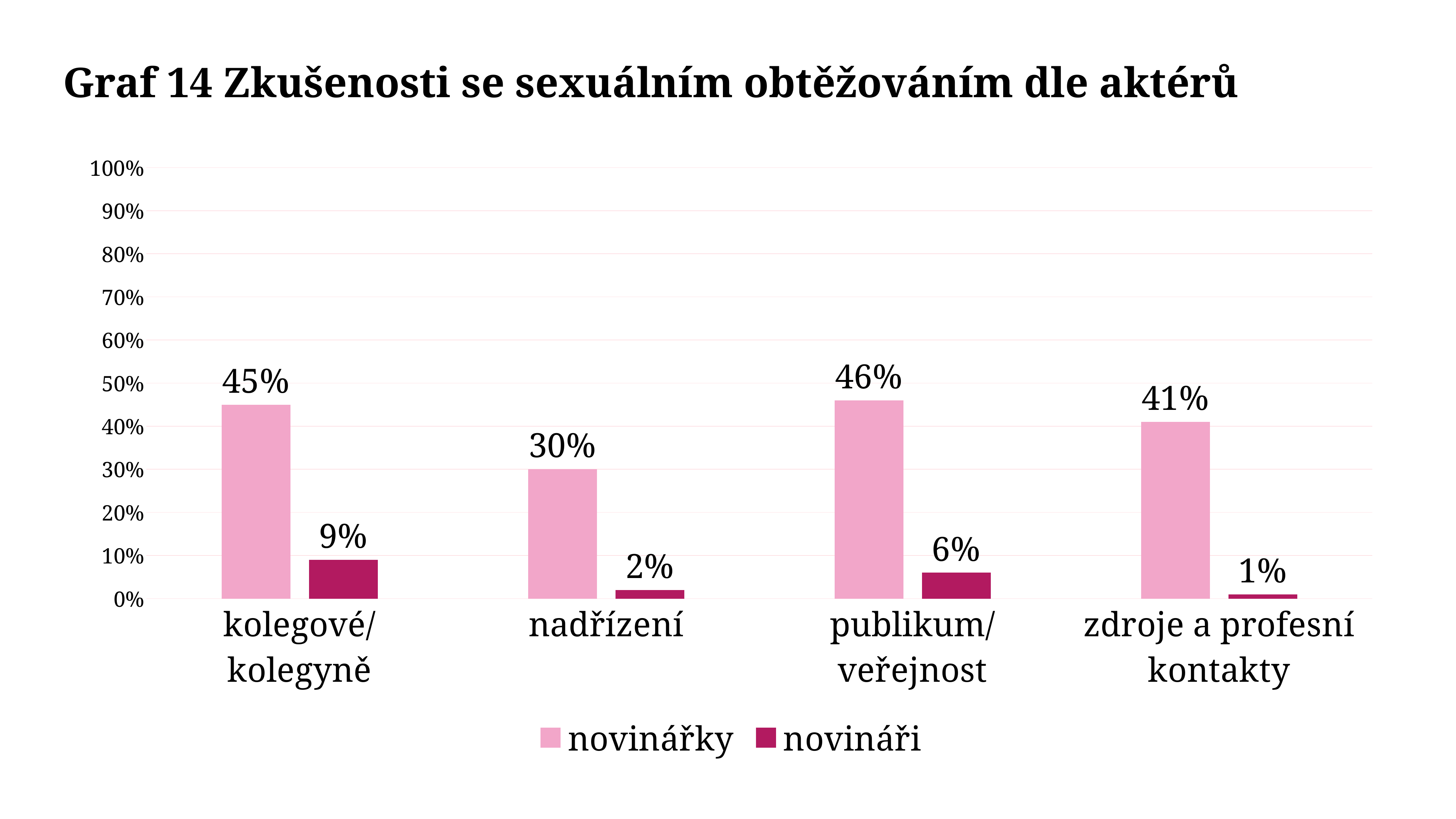
What kind of chart is shown on the slide? bar chart What is the difference between the novinářky and novináři values in the publikum/veřejnost category? 40% What is the value for novináři in the nadřízení category? 2% How many categories are shown on the x axis? 4 Which category has the lowest value for novinářky? nadřízení What is the title of the chart? Graf 14 Zkušenosti se sexuálním obtěžováním dle aktérů What is the value for novinářky in the kolegové/kolegyně category? 45% Which is larger: the novinářky value for kolegové/kolegyně or for nadřízení? kolegové/kolegyně Which category has the highest value for novináři? kolegové/kolegyně What is the value for novináři in the zdroje a profesní kontakty category? 1% How many series does the legend list? 2 What is the value for novinářky in the publikum/veřejnost category? 46%